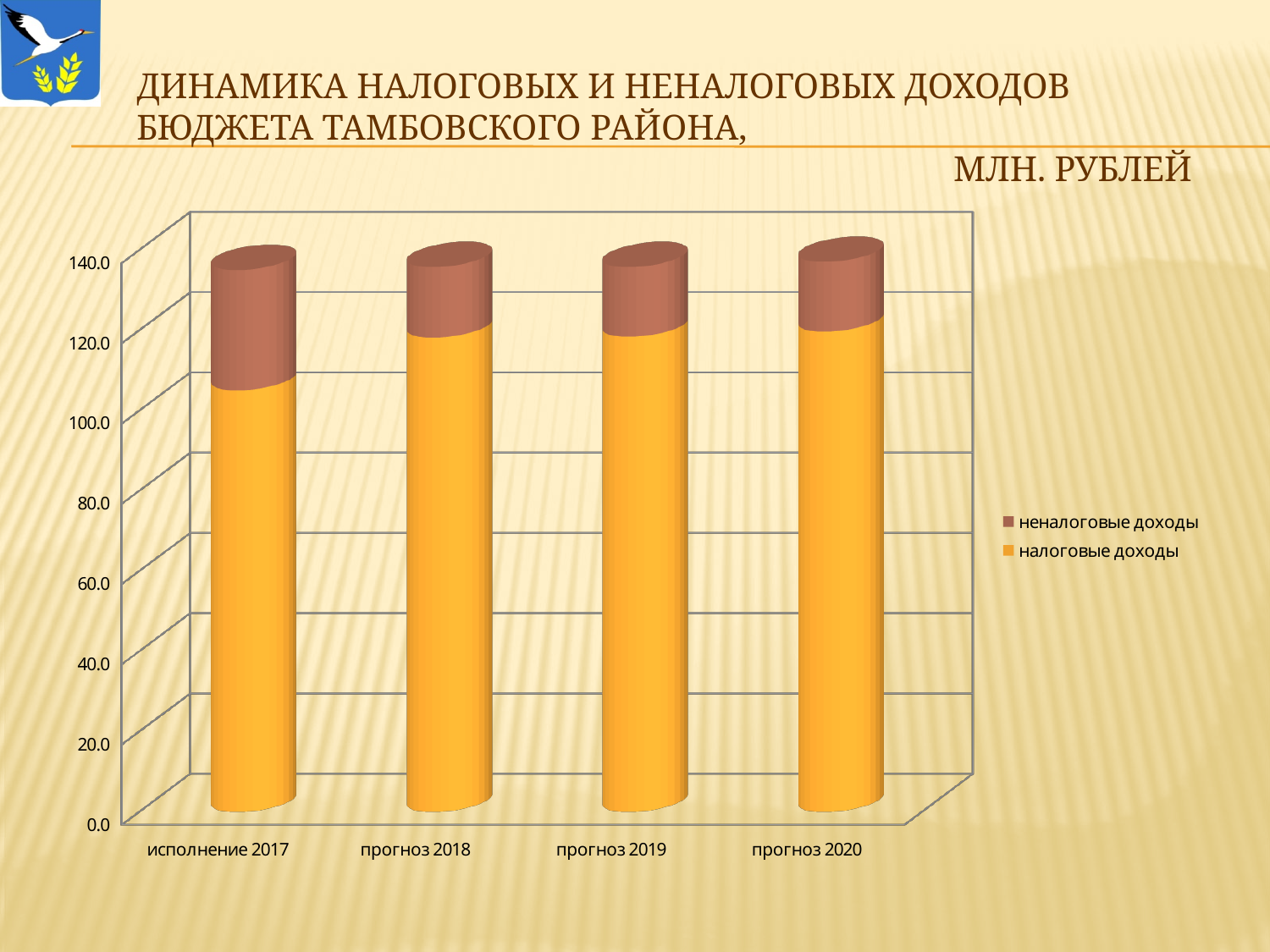
Which series are listed in the chart legend? неналоговые доходы, налоговые доходы Which category has the highest value for неналоговые доходы? исполнение 2017 What kind of chart is shown on the slide? stacked bar chart Do the values for налоговые доходы rise or fall from исполнение 2017 to прогноз 2020? rise How many categories are shown on the x axis of the chart? 4 Is the value for налоговые доходы in исполнение 2017 greater or less than 120.0? less Which is larger: неналоговые доходы in исполнение 2017 or in прогноз 2019? исполнение 2017 How many series does the chart legend list? 2 Is the value for налоговые доходы in исполнение 2017 greater or less than 100.0? greater Which category has the lowest value for налоговые доходы? исполнение 2017 Is the value for неналоговые доходы in исполнение 2017 greater or less than 20.0? greater Which is larger: налоговые доходы in исполнение 2017 or in прогноз 2020? прогноз 2020